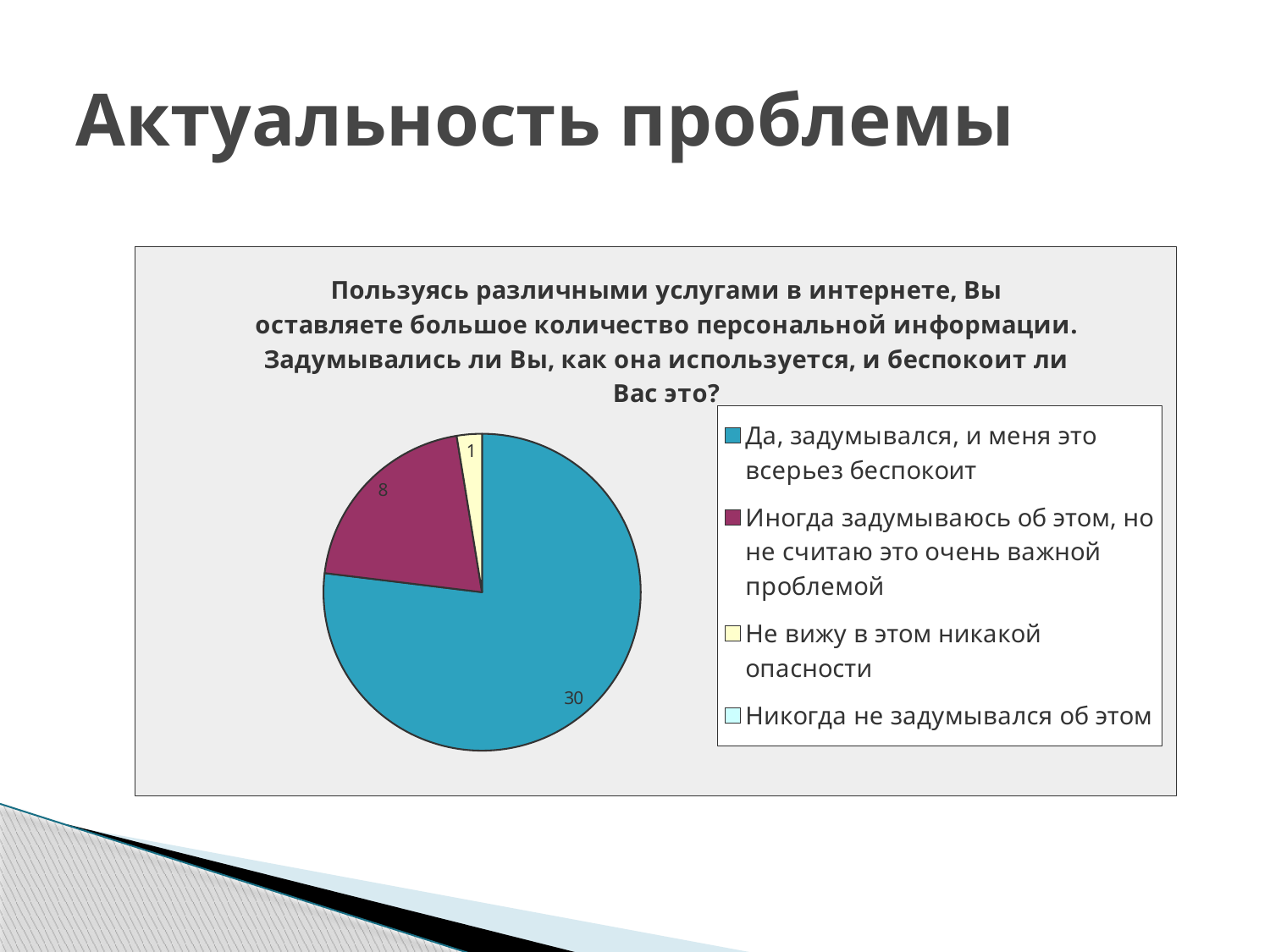
How many entries does the legend list? 4 What colour is the slice for "Да, задумывался, и меня это всерьез беспокоит"? teal blue Which is larger: the value for "Иногда задумываюсь об этом, но не считаю это очень важной проблемой" or for "Не вижу в этом никакой опасности"? Иногда задумываюсь об этом, но не считаю это очень важной проблемой What type of chart is shown on the slide? pie chart Which category has the largest slice of the pie? Да, задумывался, и меня это всерьез беспокоит What is the value for "Не вижу в этом никакой опасности"? 1 What is the difference between the values for "Да, задумывался, и меня это всерьез беспокоит" and "Иногда задумываюсь об этом, но не считаю это очень важной проблемой"? 22 Which labelled slice is the smallest? Не вижу в этом никакой опасности What is the value for "Иногда задумываюсь об этом, но не считаю это очень важной проблемой"? 8 What is the value for "Да, задумывался, и меня это всерьез беспокоит"? 30 How many slices with data labels are visible in the pie? 3 What is the difference between the values for "Иногда задумываюсь об этом, но не считаю это очень важной проблемой" and "Не вижу в этом никакой опасности"? 7